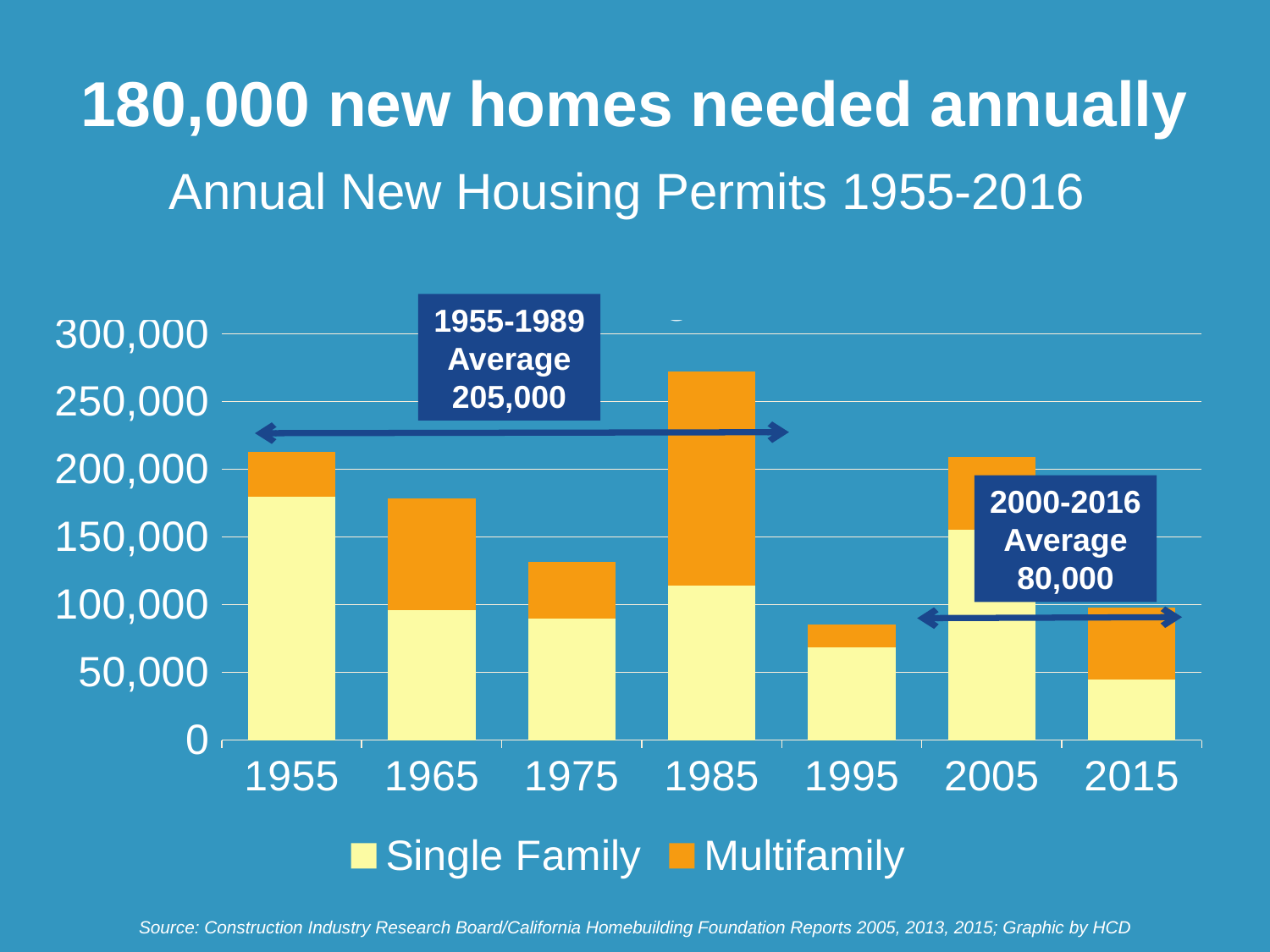
Which year has the larger total number of permits, 1955 or 1975? 1955 How many years are shown on the x axis? 7 How many series does the legend list? 2 Is the total value for 1985 greater or less than 250,000? greater According to the annotation on the chart, what was the average annual number of permits for 2000-2016? 80,000 Which year has the lowest total number of housing permits? 1995 Which year has the larger Single Family value, 1955 or 2005? 1955 What kind of chart is shown on the slide? stacked bar chart According to the annotation on the chart, what was the average annual number of permits for 1955-1989? 205,000 Is the total value for 1995 greater or less than 100,000? less Is the Single Family value for 2015 greater or less than 50,000? less Which year has the highest total number of housing permits? 1985